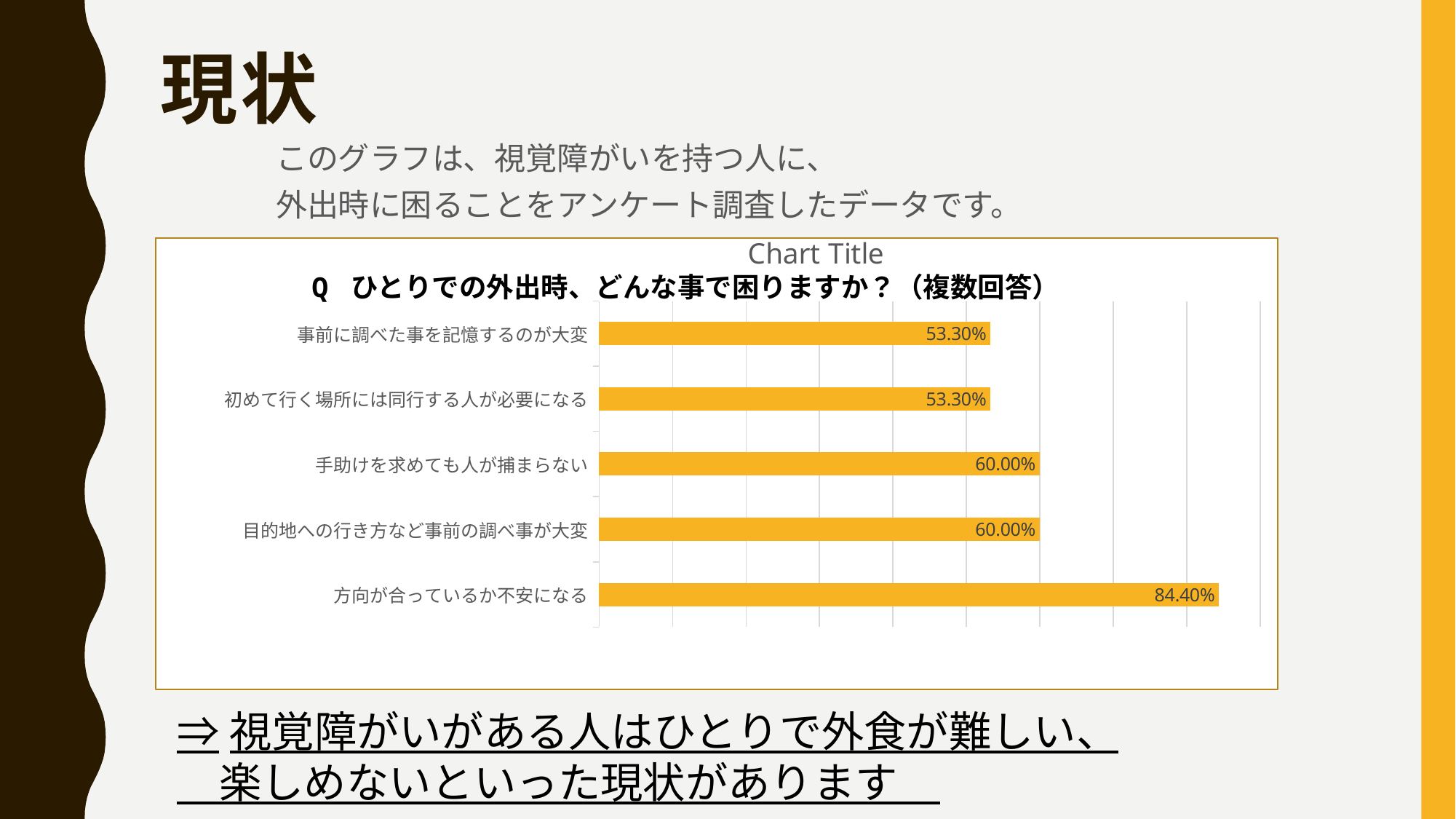
What colour are the bars in the chart? Orange What is the difference between the values for 方向が合っているか不安になる and 手助けを求めても人が捕まらない? 24.40% What is the value for 事前に調べた事を記憶するのが大変? 53.30% Which category has the highest value? 方向が合っているか不安になる What is the difference between the values for 目的地への行き方など事前の調べ事が大変 and 初めて行く場所には同行する人が必要になる? 6.70% How many categories are shown in the chart? 5 What is the value for 手助けを求めても人が捕まらない? 60.00% What is the value for 方向が合っているか不安になる? 84.40% What is the title shown at the top of the chart? Chart Title What kind of chart is shown on the slide? Bar chart What is the value for 目的地への行き方など事前の調べ事が大変? 60.00% Which is larger, the value for 方向が合っているか不安になる or the value for 初めて行く場所には同行する人が必要になる? 方向が合っているか不安になる